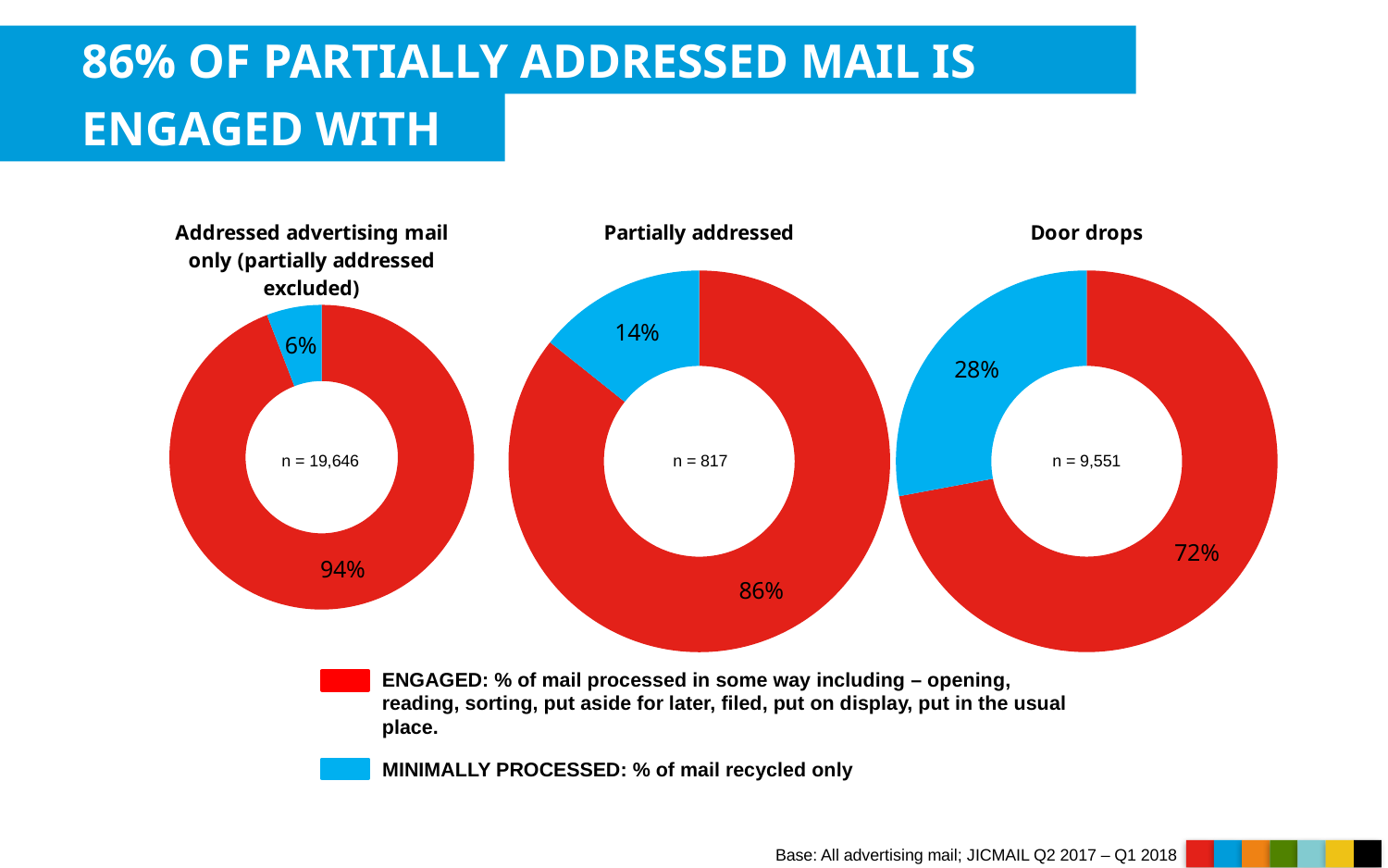
Which of the three charts has the largest engaged share? Addressed advertising mail only (partially addressed excluded) What is the sample size (n) shown in the centre of the 'Partially addressed' chart? n = 817 In the 'Partially addressed' chart, what percentage of mail is minimally processed? 14% Which of the three charts has the largest minimally processed share? Door drops What type of chart is used on this slide? Doughnut chart What is the difference between the engaged share in the 'Partially addressed' chart and the engaged share in the 'Door drops' chart? 14% In the 'Partially addressed' chart, what percentage of mail is engaged with? 86% In the 'Door drops' chart, what percentage of mail is engaged with? 72% In the 'Door drops' chart, what percentage of mail is minimally processed? 28% Which colour represents 'MINIMALLY PROCESSED' in the legend? Blue In the 'Addressed advertising mail only (partially addressed excluded)' chart, what percentage of mail is engaged with? 94% What is the sample size (n) shown in the centre of the 'Door drops' chart? n = 9,551